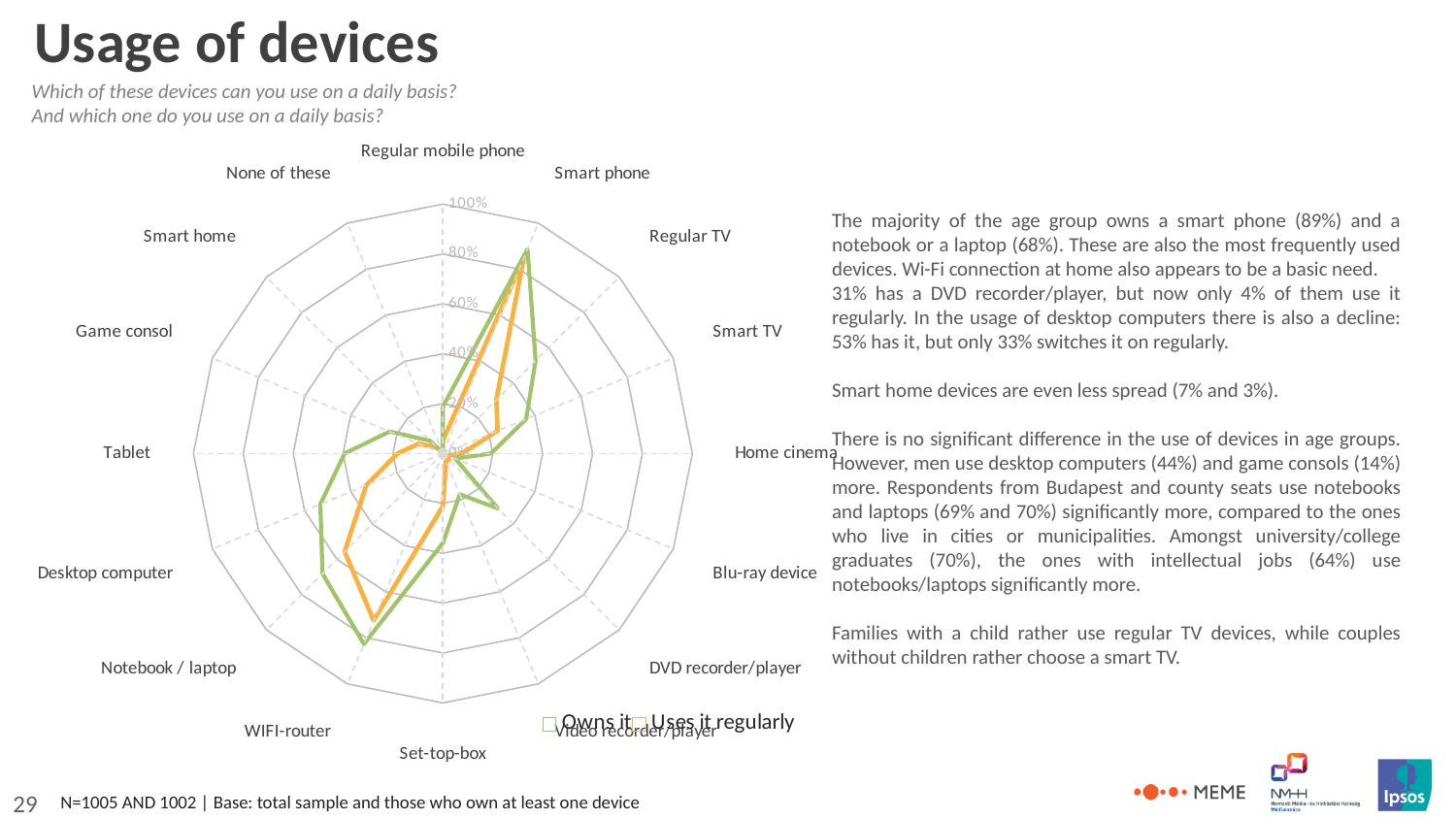
For the 'Owns it' series, which is larger: Smart phone or Regular TV? Smart phone For DVD recorder/player, which series has the larger value: 'Owns it' or 'Uses it regularly'? Owns it What are the two series named in the chart legend? Owns it; Uses it regularly Is the 'Uses it regularly' value for DVD recorder/player greater or less than 20%? less Is the 'Owns it' value for Smart home greater or less than 20%? less Is the 'Owns it' value for Smart phone greater or less than 80%? greater How many series does the chart legend list? 2 How many device categories are plotted on the radar chart? 16 What kind of chart is shown on the slide? Radar chart Which device has the highest value for the 'Owns it' series? Smart phone What is the title of the slide containing the chart? Usage of devices